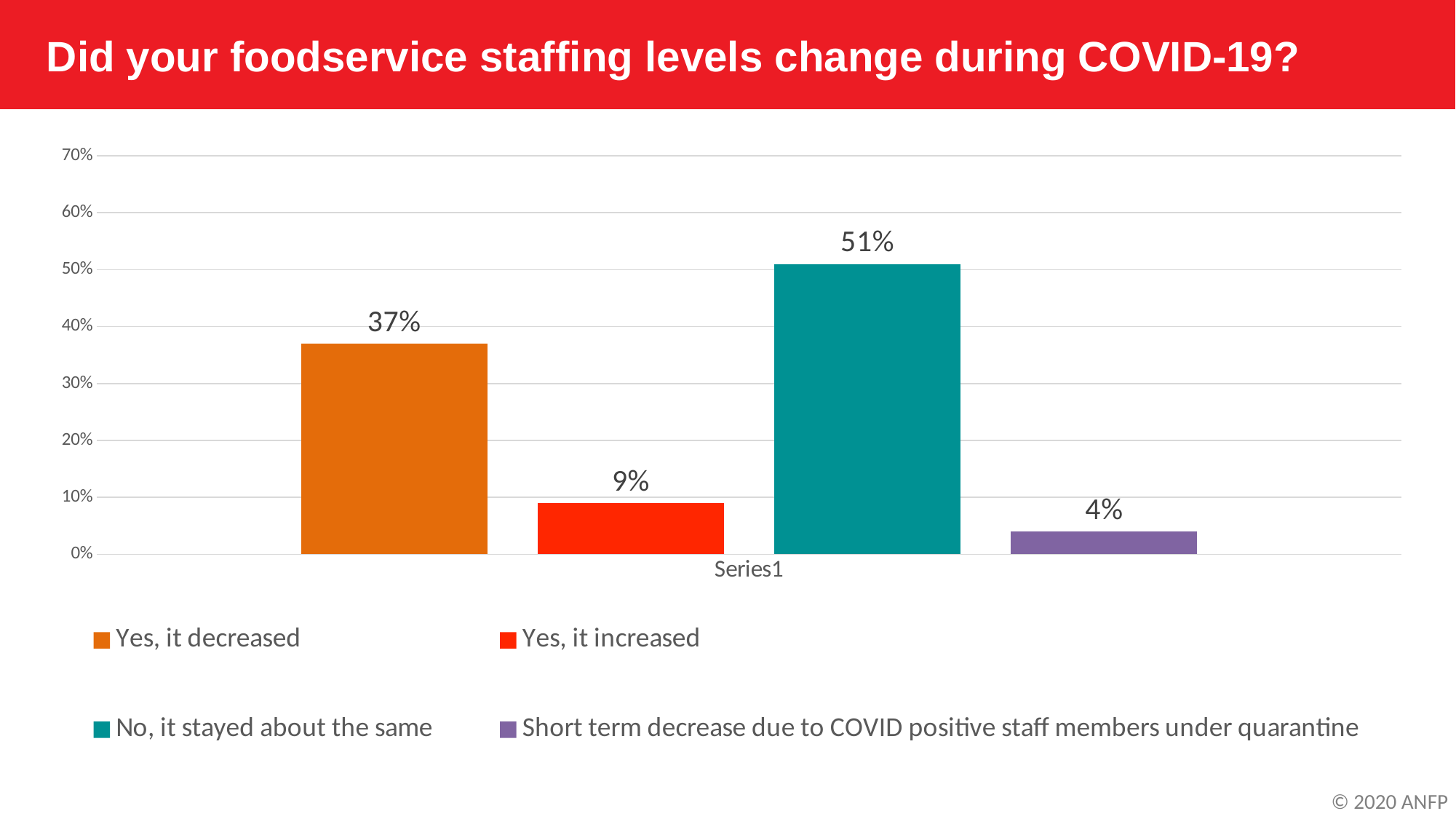
What colour is the bar for 'No, it stayed about the same'? Teal What percentage of respondents said their foodservice staffing levels decreased? 37% How many response categories are shown in the chart? 4 What is the difference in percentage points between 'No, it stayed about the same' and 'Yes, it decreased'? 14 What percentage reported a short term decrease due to COVID positive staff members under quarantine? 4% Which is larger: the percentage for 'Yes, it decreased' or 'Yes, it increased'? Yes, it decreased What percentage of respondents said staffing stayed about the same? 51% Which response has the highest percentage? No, it stayed about the same Is the value for 'Yes, it decreased' greater or less than 40%? less What percentage of respondents said their foodservice staffing levels increased? 9% What kind of chart is shown on the slide? Bar chart Which response has the lowest percentage? Short term decrease due to COVID positive staff members under quarantine